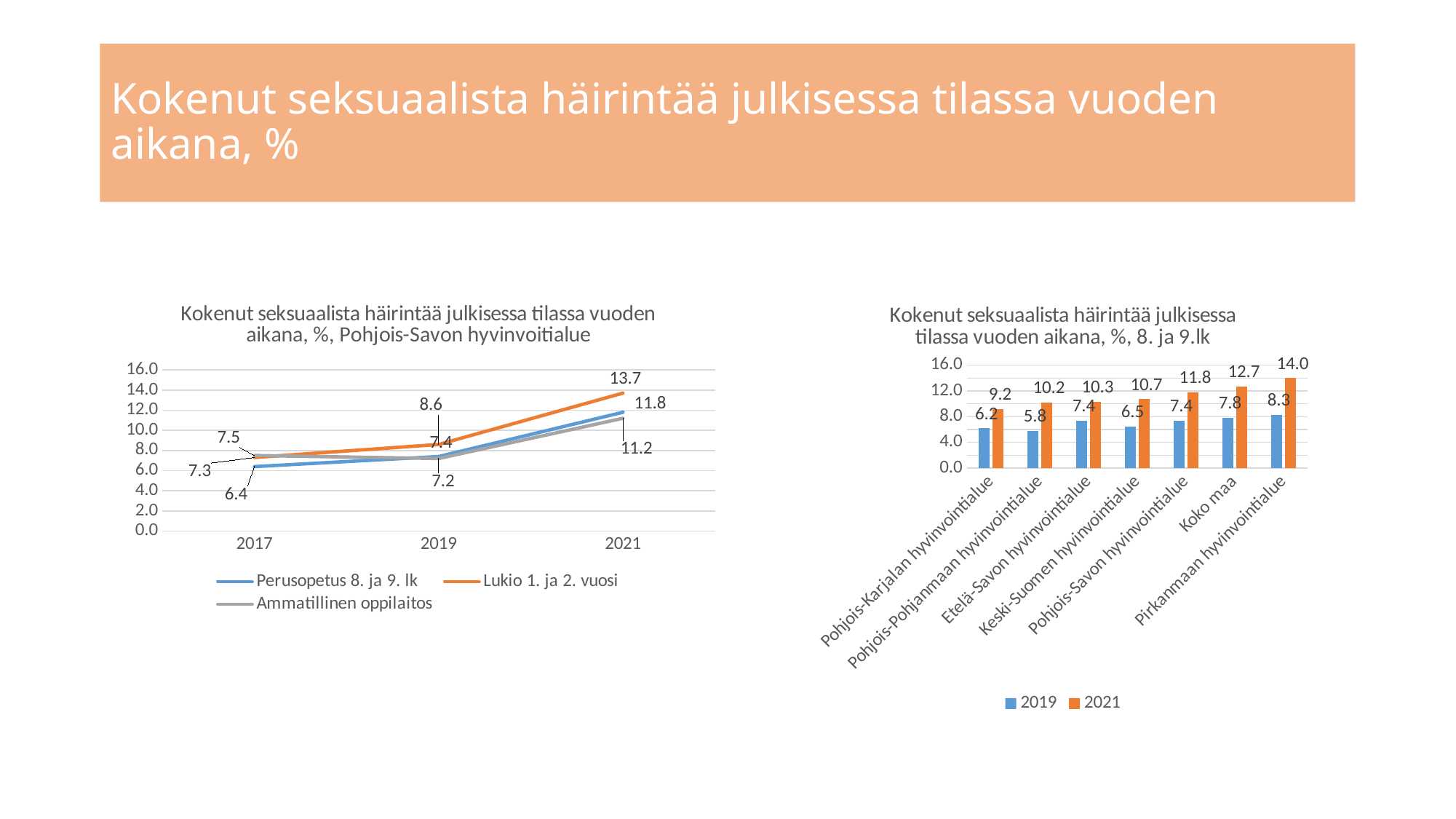
In the left chart (Pohjois-Savon hyvinvointialue), does the Lukio 1. ja 2. vuosi line rise or fall from 2017 to 2021? Rise What type of chart is the left chart, titled "Kokenut seksuaalista häirintää julkisessa tilassa vuoden aikana, %, Pohjois-Savon hyvinvointialue"? Line chart In the right chart (8. ja 9.lk), how many categories are shown on the x axis? 7 In the left chart (Pohjois-Savon hyvinvointialue), how many series does the legend list? 3 What type of chart is the right chart, titled "Kokenut seksuaalista häirintää julkisessa tilassa vuoden aikana, %, 8. ja 9.lk"? Bar chart In the left chart (Pohjois-Savon hyvinvointialue), what is the difference between Lukio 1. ja 2. vuosi and Perusopetus 8. ja 9. lk in 2021? 1.9 In the left chart (Pohjois-Savon hyvinvointialue), what is the value for Perusopetus 8. ja 9. lk in 2017? 6.4 In the right chart (8. ja 9.lk), what is the 2019 value for Koko maa? 7.8 In the right chart (8. ja 9.lk), what is the 2021 value for Pirkanmaan hyvinvointialue? 14.0 In the left chart (Pohjois-Savon hyvinvointialue), what is the value for Lukio 1. ja 2. vuosi in 2021? 13.7 In the right chart (8. ja 9.lk), which region has the lowest 2019 value? Pohjois-Pohjanmaan hyvinvointialue In the right chart (8. ja 9.lk), what is the difference between the 2021 and 2019 values for Pohjois-Savon hyvinvointialue? 4.4